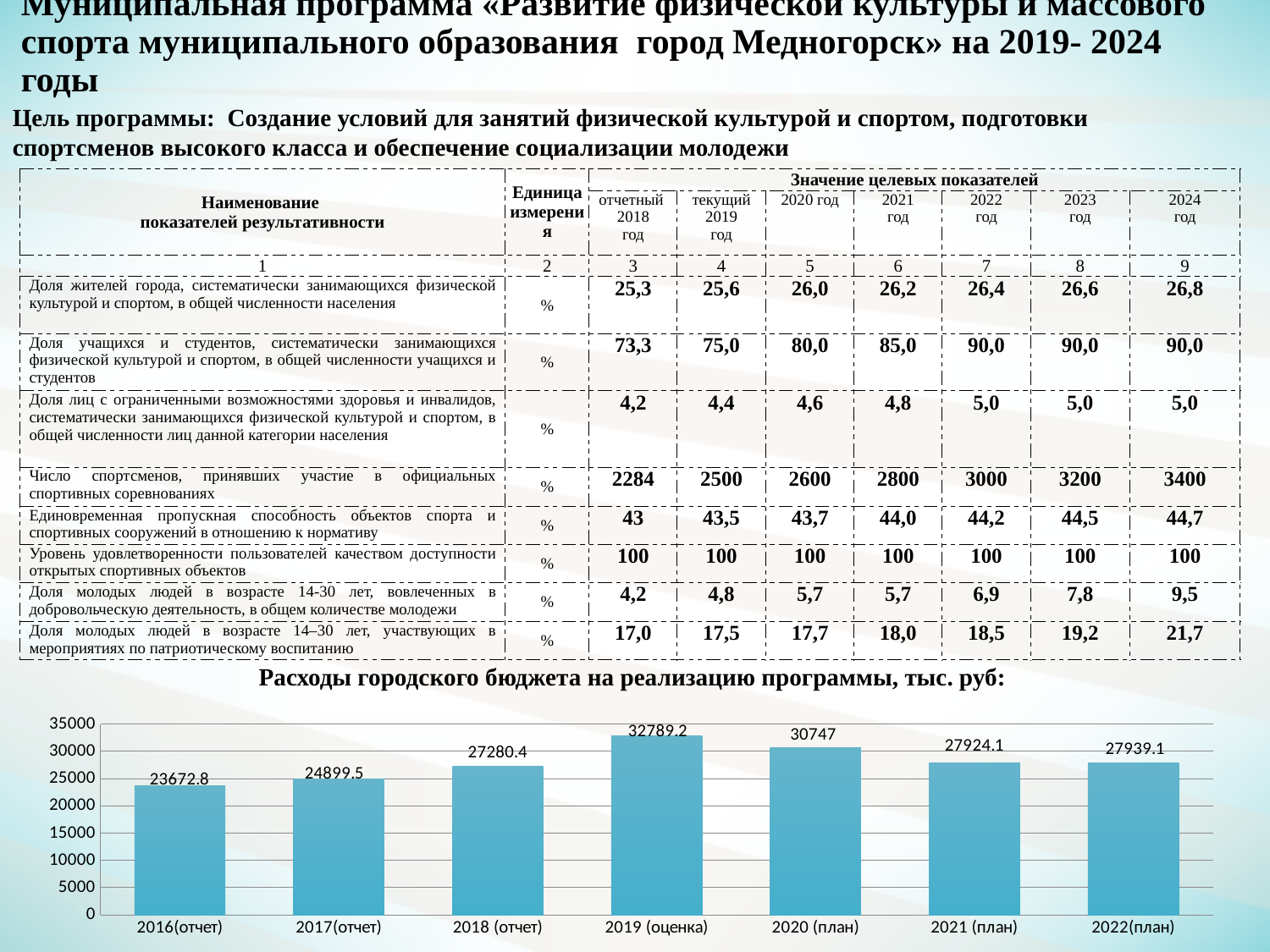
What is the value for 2019 (оценка) in the bar chart? 32789.2 How many bars are shown in the bar chart? 7 What is the value for 2016(отчет) in the bar chart? 23672.8 Which year has the highest value in the bar chart? 2019 (оценка) Which year has the lowest value in the bar chart? 2016(отчет) What is the value for 2022(план) in the bar chart? 27939.1 What is the difference between the values for 2019 (оценка) and 2020 (план)? 2042.2 What is the value for 2020 (план) in the bar chart? 30747 What kind of chart is shown at the bottom of the slide? bar chart Which is larger in the bar chart: the value for 2018 (отчет) or the value for 2020 (план)? 2020 (план) What is the title of the bar chart? Расходы городского бюджета на реализацию программы, тыс. руб: Is the value for 2019 (оценка) greater or less than 30000? greater